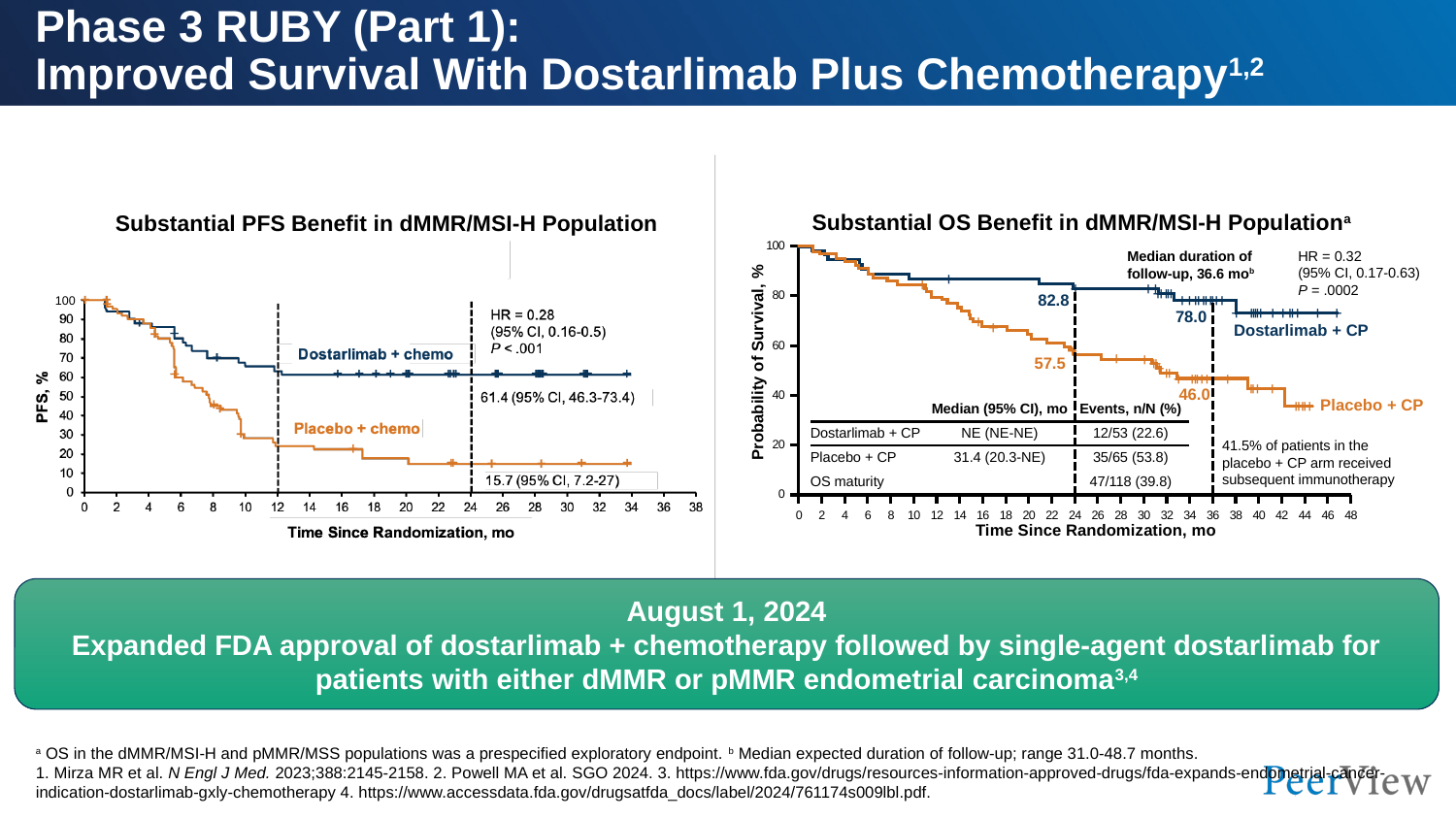
In the right chart (Substantial OS Benefit in dMMR/MSI-H Population), how many events, n/N (%), are listed for the Dostarlimab + CP arm? 12/53 (22.6) In the left chart (Substantial PFS Benefit in dMMR/MSI-H Population), is the PFS value for the Placebo + chemo arm at 24 months greater or less than 20? less In the left chart (Substantial PFS Benefit in dMMR/MSI-H Population), what is the 24-month PFS rate printed for the Placebo + chemo arm? 15.7 (95% CI, 7.2-27) In the left chart (Substantial PFS Benefit in dMMR/MSI-H Population), what is the 24-month PFS rate printed for the Dostarlimab + chemo arm? 61.4 (95% CI, 46.3-73.4) In the right chart (Substantial OS Benefit in dMMR/MSI-H Population), what is the hazard ratio shown? HR = 0.32 In the right chart (Substantial OS Benefit in dMMR/MSI-H Population), what is the probability of survival printed for the Placebo + CP arm at 36 months? 46.0 In the right chart (Substantial OS Benefit in dMMR/MSI-H Population), does the probability of survival for the Placebo + CP arm rise or fall over time since randomization? fall In the right chart (Substantial OS Benefit in dMMR/MSI-H Population), what is the difference between the 24-month survival values printed for Dostarlimab + CP (82.8) and Placebo + CP (57.5)? 25.3 In the right chart (Substantial OS Benefit in dMMR/MSI-H Population), what is the probability of survival printed for the Dostarlimab + CP arm at 24 months? 82.8 In the right chart (Substantial OS Benefit in dMMR/MSI-H Population), what is the median OS (95% CI) listed for the Placebo + CP arm? 31.4 (20.3-NE) In the left chart (Substantial PFS Benefit in dMMR/MSI-H Population), which arm has the higher PFS at 24 months, Dostarlimab + chemo or Placebo + chemo? Dostarlimab + chemo In the left chart (Substantial PFS Benefit in dMMR/MSI-H Population), what is the hazard ratio shown? HR = 0.28